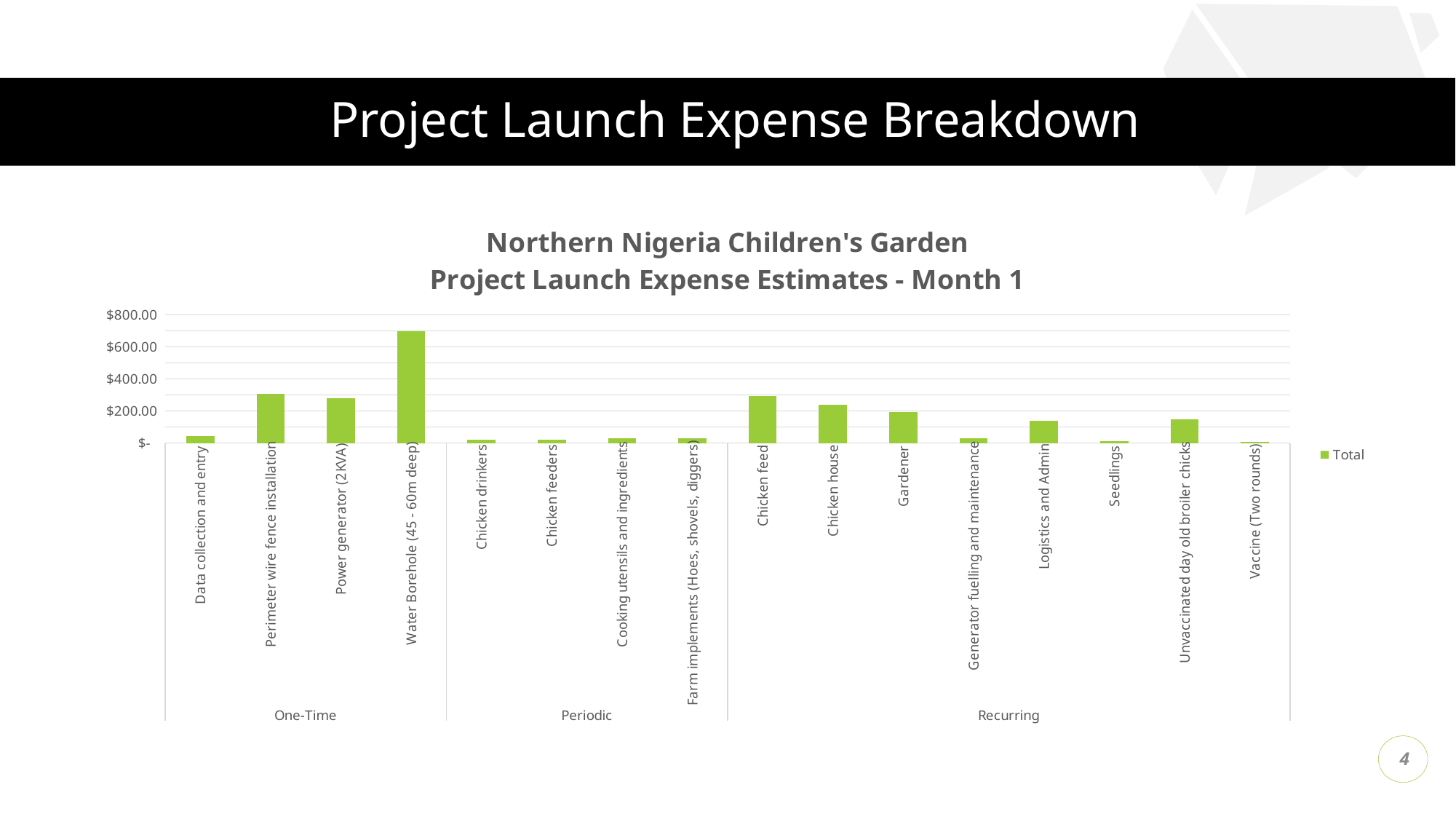
Which is larger, the value for Water Borehole (45 - 60m deep) or the value for Perimeter wire fence installation? Water Borehole (45 - 60m deep) How many series does the legend list? 1 What are the three expense groups labelled along the bottom of the chart? One-Time, Periodic, Recurring Which is larger, the value for Chicken feed or the value for Gardener? Chicken feed Is the value for Chicken feed greater or less than $200.00? greater Is the value for Logistics and Admin greater or less than $200.00? less Which category has the highest value in the chart? Water Borehole (45 - 60m deep) Is the value for Perimeter wire fence installation greater or less than $200.00? greater How many expense categories are plotted in the chart? 16 What type of chart is shown on the slide? Bar chart